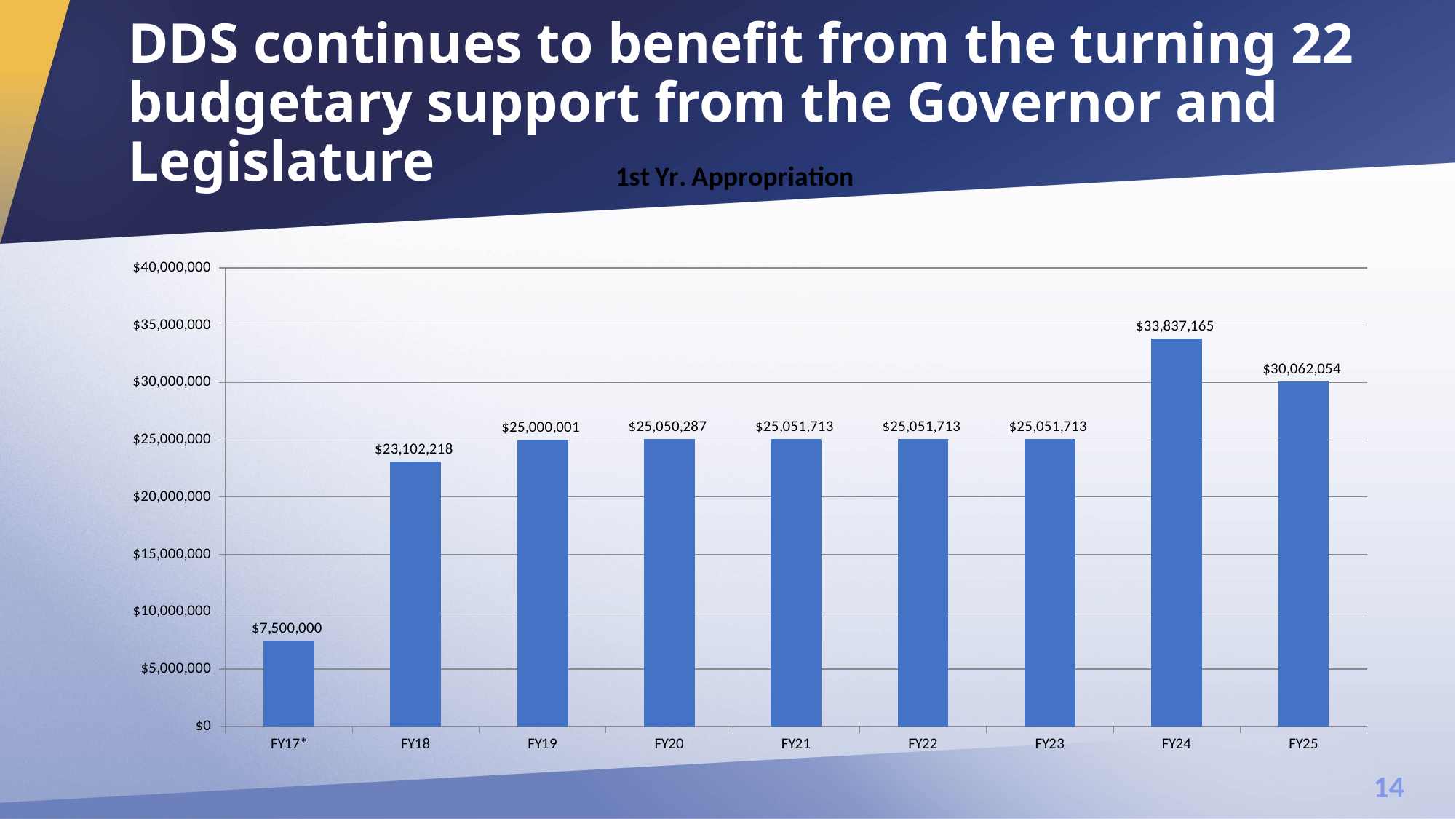
What is the title of the chart? 1st Yr. Appropriation Is the value for FY18 greater or less than $25,000,000? less What is the 1st Yr. Appropriation value for FY24? $33,837,165 Which is larger, the appropriation for FY25 or for FY23? FY25 What is the 1st Yr. Appropriation value for FY20? $25,050,287 Which fiscal year has the highest 1st Yr. Appropriation? FY24 How many fiscal years are shown on the x axis of the chart? 9 What is the difference between the FY18 and FY17* appropriation values? $15,602,218 What is the difference between the FY24 and FY25 appropriation values? $3,775,111 What is the 1st Yr. Appropriation value for FY17*? $7,500,000 What type of chart is shown on the slide? Bar chart Which fiscal year has the lowest 1st Yr. Appropriation? FY17*